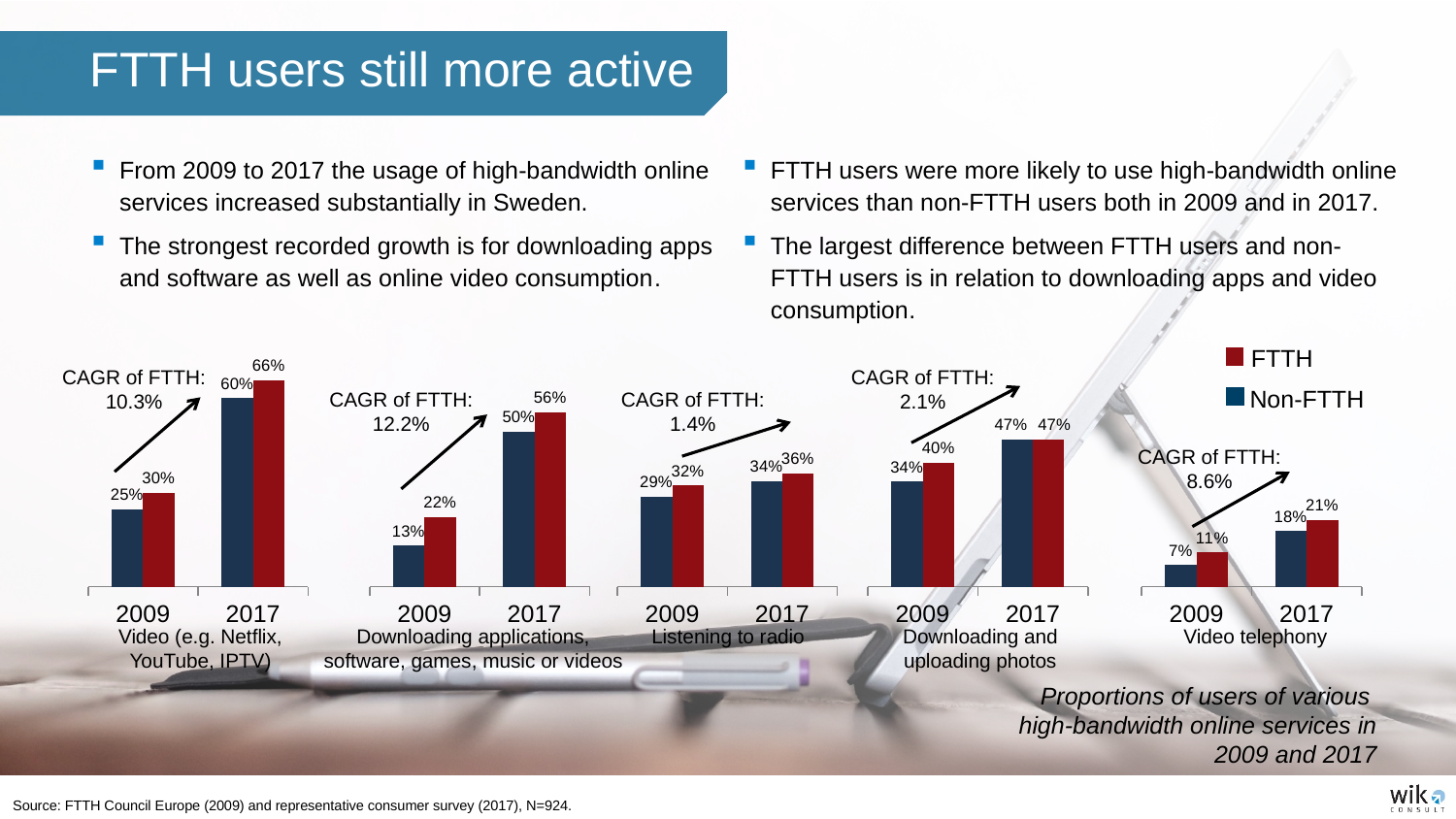
How many series does the legend list? 2 In the 'Listening to radio' chart, what is the value for Non-FTTH users in 2017? 34% Which colour represents FTTH users in the legend? red In the 'Downloading applications, software, games, music or videos' chart, what is the value for FTTH users in 2009? 22% In the 'Video telephony' chart, what is the value for Non-FTTH users in 2009? 7% In the 'Video telephony' chart, what is the difference between FTTH users in 2017 and FTTH users in 2009? 10% In the 'Video telephony' chart, do the values rise or fall from 2009 to 2017? rise What kind of chart is the 'Listening to radio' chart? bar chart In the 'Video (e.g. Netflix, YouTube, IPTV)' chart, what is the value for Non-FTTH users in 2009? 25% In the 'Video (e.g. Netflix, YouTube, IPTV)' chart, what is the value for FTTH users in 2017? 66% In the 'Downloading applications, software, games, music or videos' chart, what is the difference between FTTH and Non-FTTH users in 2017? 6% In the 'Downloading and uploading photos' chart, which is larger in 2009, FTTH or Non-FTTH? FTTH